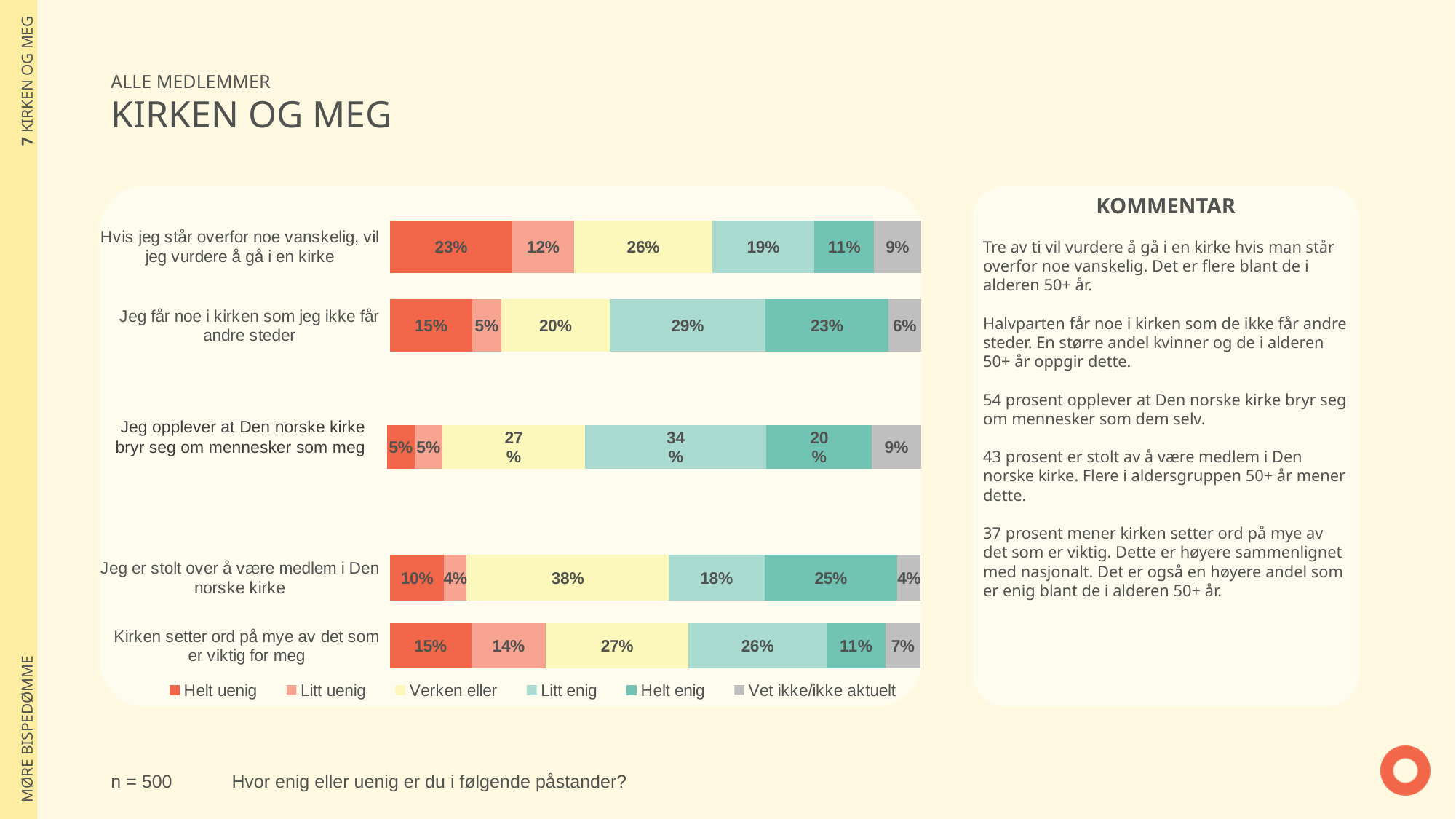
How many statements (bars) are shown in the chart? 5 What is the "Litt enig" value for "Jeg opplever at Den norske kirke bryr seg om mennesker som meg"? 34% What is the "Helt enig" value for "Jeg er stolt over å være medlem i Den norske kirke"? 25% Which statement has the lowest "Helt uenig" share? Jeg opplever at Den norske kirke bryr seg om mennesker som meg What is the difference between the "Litt enig" and "Helt enig" values for "Jeg får noe i kirken som jeg ikke får andre steder"? 6% Which is larger for "Kirken setter ord på mye av det som er viktig for meg": the "Helt uenig" share or the "Litt uenig" share? Helt uenig Which statement has the highest "Verken eller" share? Jeg er stolt over å være medlem i Den norske kirke What is the combined share of "Litt enig" and "Helt enig" for "Jeg opplever at Den norske kirke bryr seg om mennesker som meg"? 54% What percentage of respondents answered "Helt uenig" to "Hvis jeg står overfor noe vanskelig, vil jeg vurdere å gå i en kirke"? 23% What is the "Vet ikke/ikke aktuelt" value for "Kirken setter ord på mye av det som er viktig for meg"? 7% How many series does the legend list? 6 What kind of chart is shown on the slide? Stacked bar chart